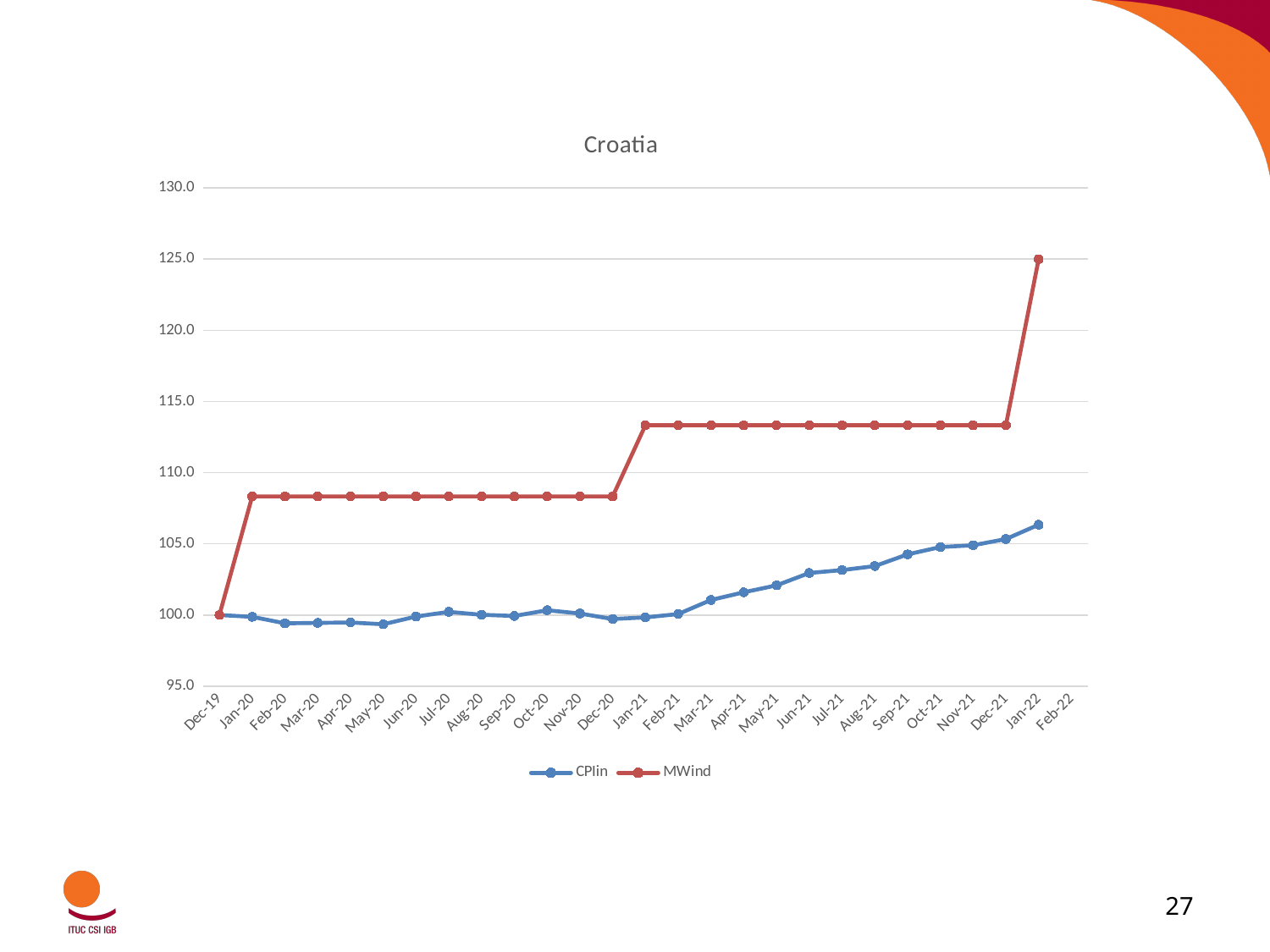
Is the value for MWind at Mar-21 greater or less than 110.0? greater What kind of chart is shown on the slide? line chart What is the title of the chart? Croatia Does the CPIin line rise or fall from Jan-21 to Jan-22? rise Is the value for CPIin at Jan-22 greater or less than 105.0? greater How many series does the legend list? 2 Is the value for MWind at Jan-22 greater or less than 120.0? greater What are the two series named in the legend? CPIin and MWind In which month does MWind reach its highest value? Jan-22 At Jan-22, which series has the higher value, CPIin or MWind? MWind What is the value of MWind at Dec-19? 100.0